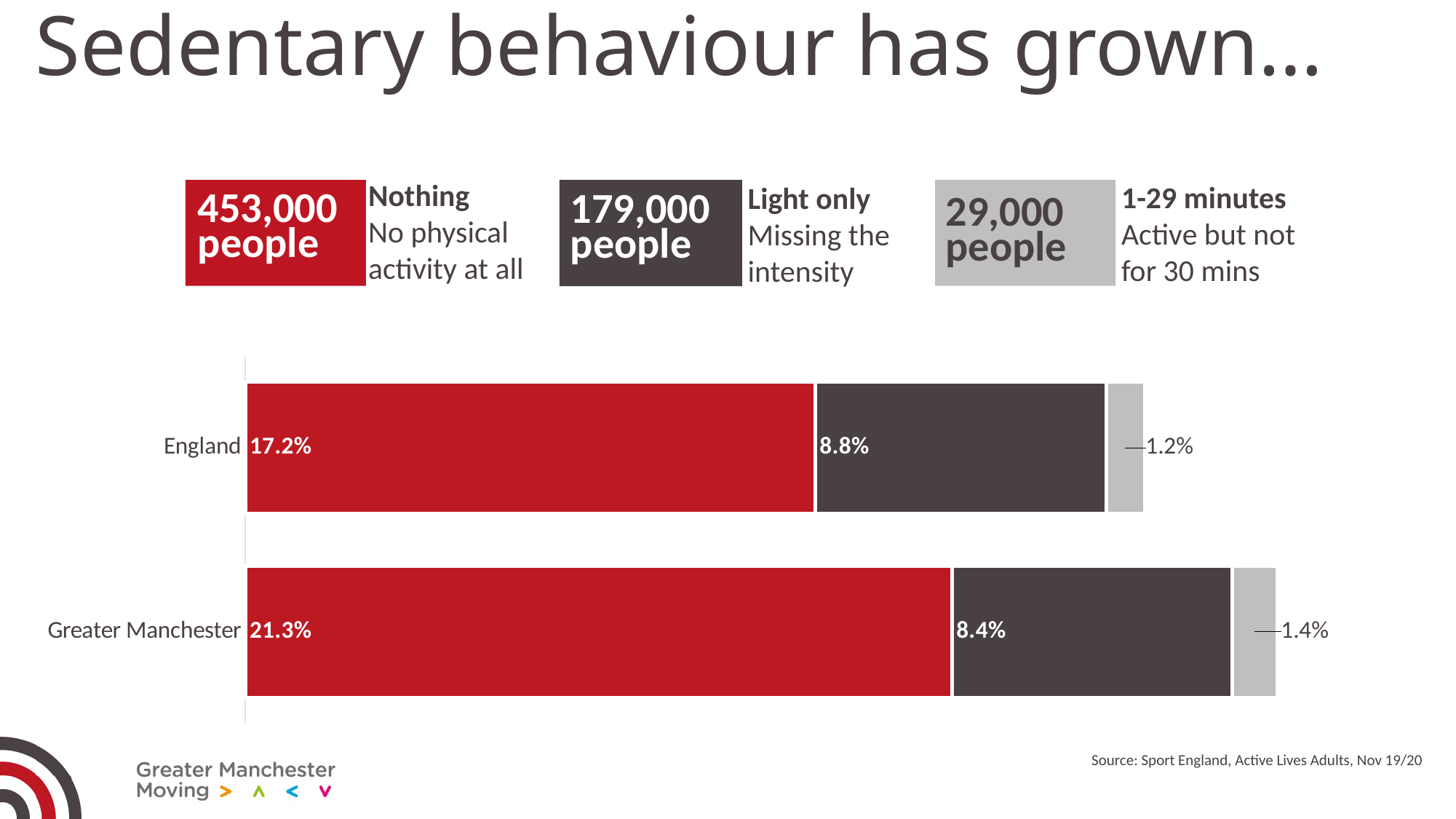
Which area has the larger red (Nothing) segment, England or Greater Manchester? Greater Manchester What is the value of the red (Nothing) segment for England? 17.2% What is the difference between the red (Nothing) values for Greater Manchester and England? 4.1% What is the value of the light grey (1-29 minutes) segment for Greater Manchester? 1.4% What is the value of the dark grey (Light only) segment for England? 8.8% What is the difference between the light grey (1-29 minutes) values for Greater Manchester and England? 0.2% How many areas (categories) are shown in the bar chart? 2 Which area has the larger dark grey (Light only) segment, England or Greater Manchester? England What is the value of the red (Nothing) segment for Greater Manchester? 21.3% What is the total of the stacked bar for England? 27.2% What kind of chart is shown on the slide? Stacked bar chart What is the total of the stacked bar for Greater Manchester? 31.1%